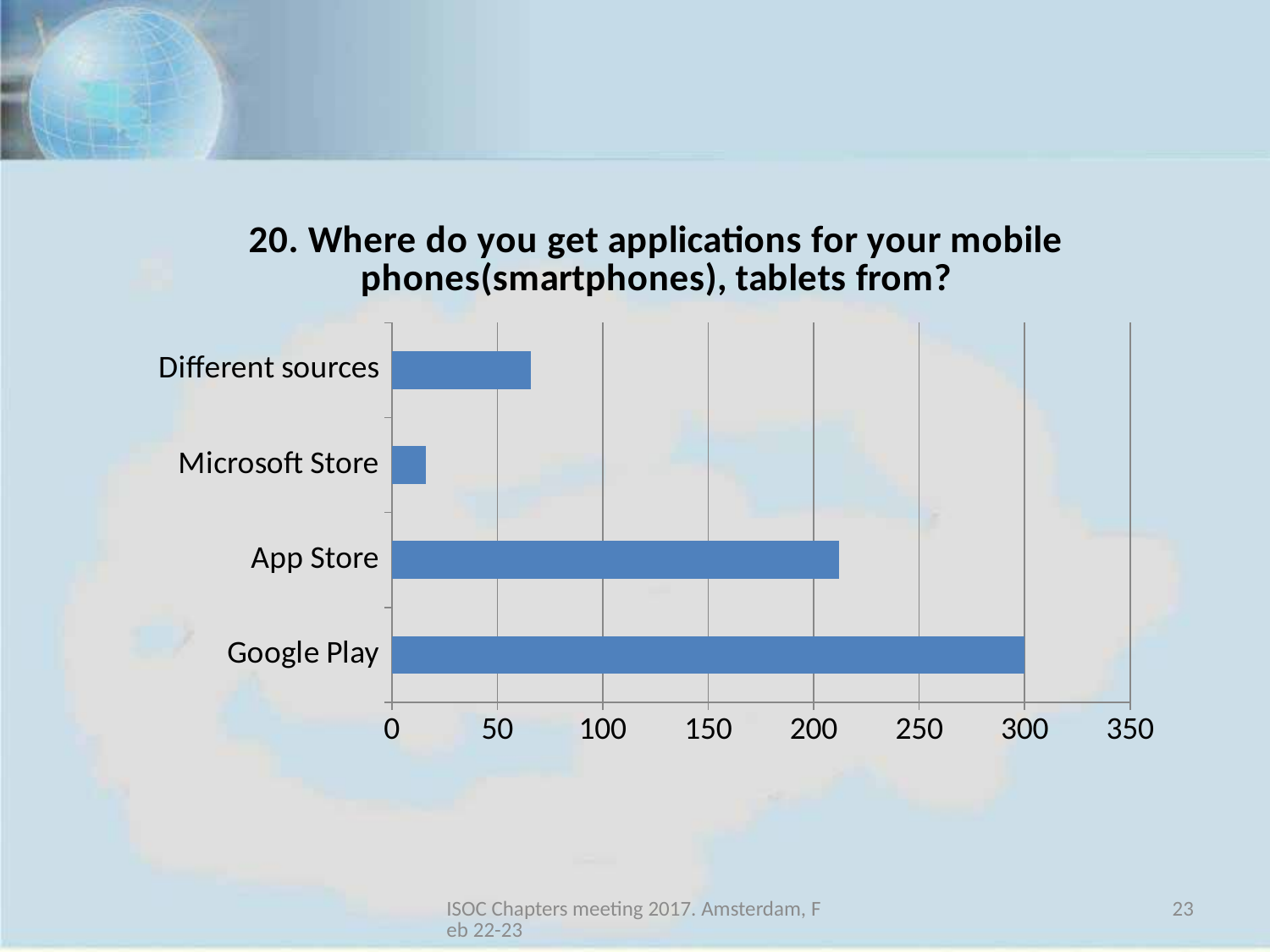
What is the title of the chart? 20. Where do you get applications for your mobile phones(smartphones), tablets from? Which category has the lowest value? Microsoft Store What type of chart is shown on the slide? bar chart Is the value for App Store greater or less than 200? greater Which is larger, the value for App Store or the value for Different sources? App Store How many categories are shown in the chart? 4 Which category has the highest value? Google Play What is the value for Google Play? 300 Is the value for Different sources greater or less than 100? less Is the value for Different sources greater or less than 50? greater